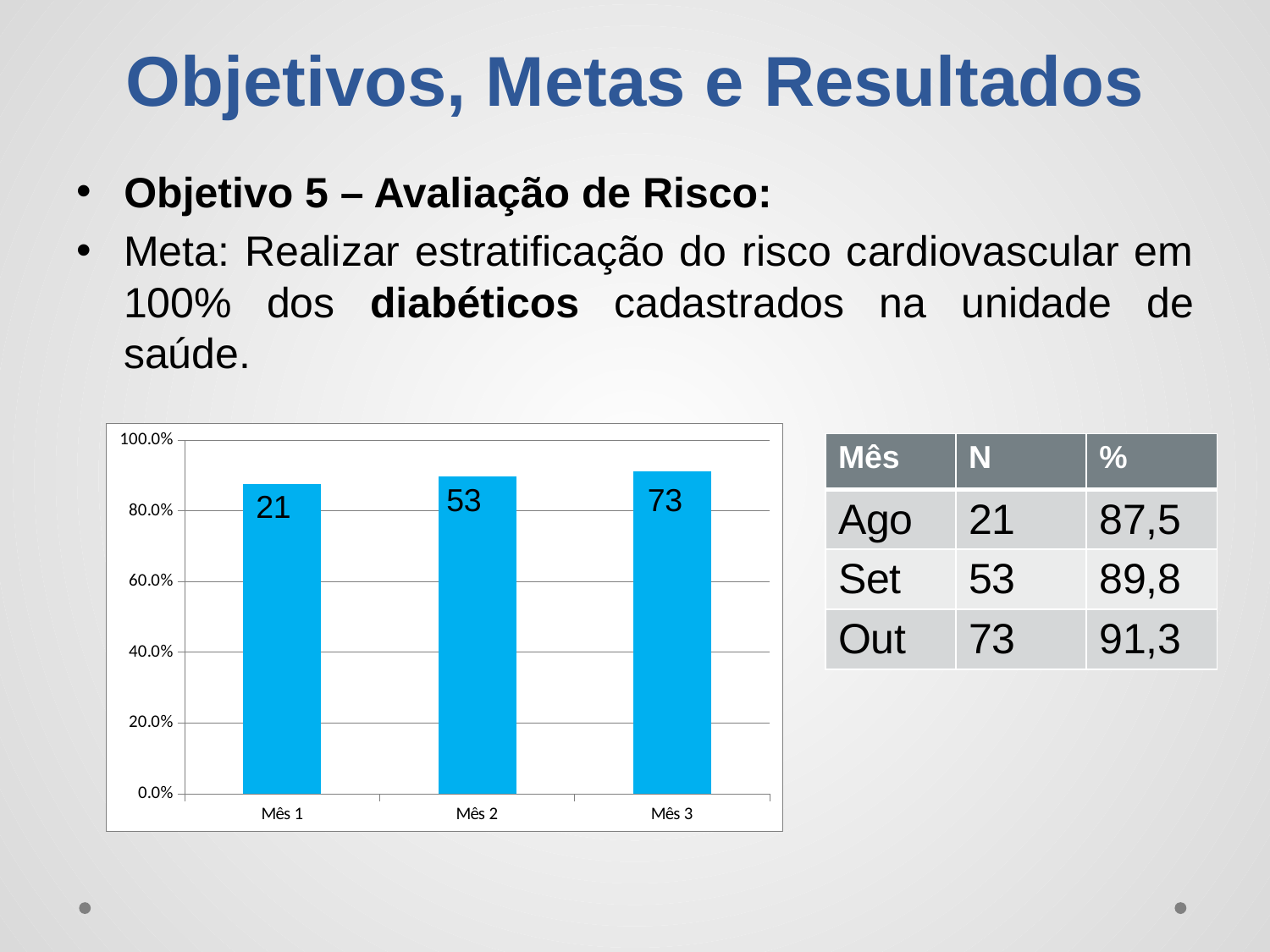
What is the data label on the bar for Mês 2? 53 Do the bars rise or fall from Mês 1 to Mês 3? Rise How many bars are shown in the chart? 3 Is the bar for Mês 3 greater or less than 100.0%? less Which month has the lowest bar in the chart? Mês 1 Which month has the highest bar in the chart? Mês 3 What is the data label on the bar for Mês 1? 21 Is the bar for Mês 1 greater or less than 80.0%? greater What is the difference between the data labels for Mês 2 and Mês 1? 32 What kind of chart is shown on the slide? Bar chart What is the difference between the data labels for Mês 3 and Mês 1? 52 What is the data label on the bar for Mês 3? 73